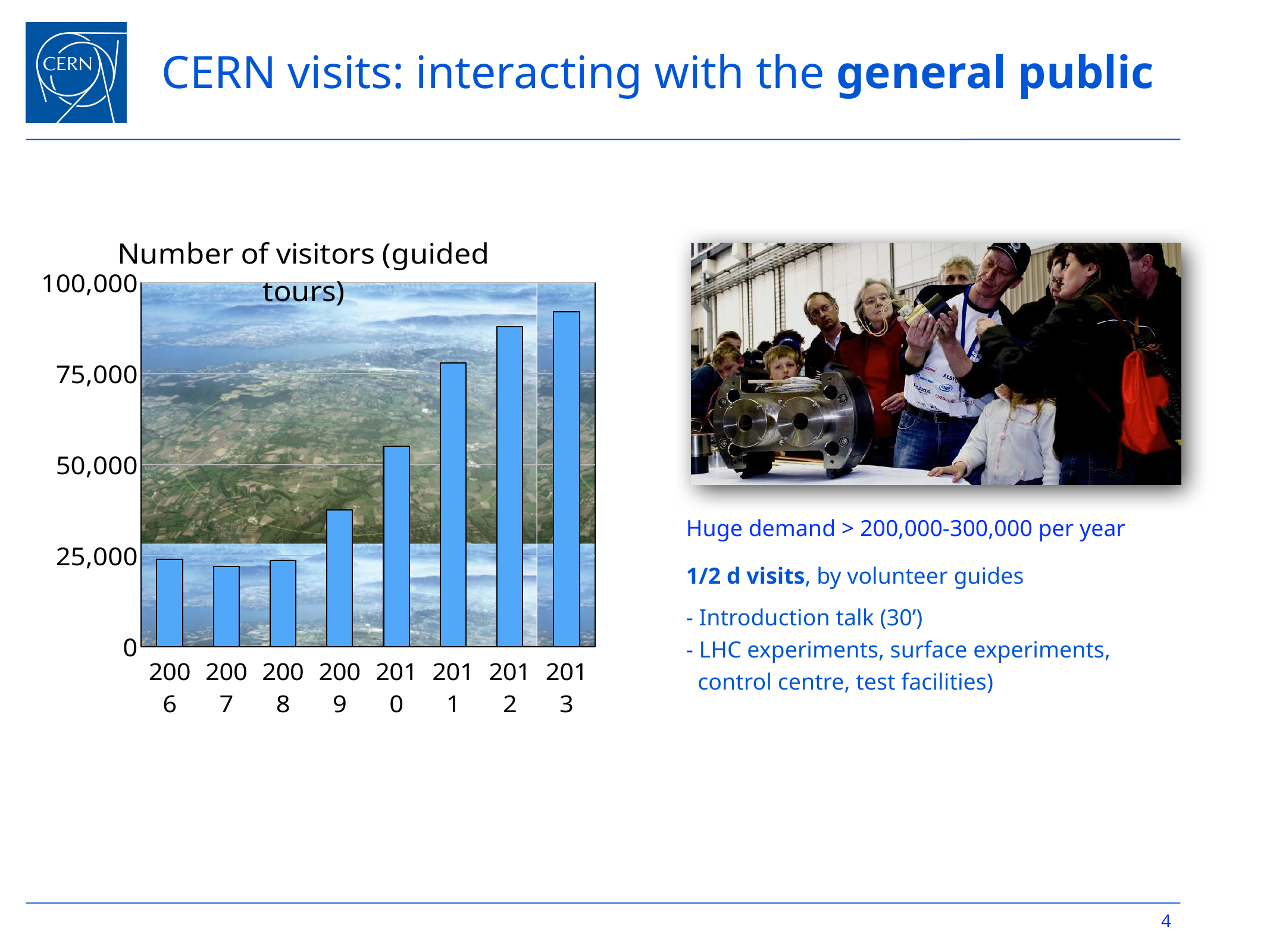
How many years are shown on the x axis of the chart? 8 Is the value for 2012 greater or less than 100,000? less Which year has the highest number of visitors? 2013 Is the value for 2013 greater or less than 75,000? greater What is the title of the chart? Number of visitors (guided tours) Which year has more visitors, 2010 or 2012? 2012 Is the value for 2010 greater or less than 75,000? less Do the number of visitors generally rise or fall from 2008 to 2013? rise What kind of chart is shown on the slide? bar chart Which year has the lowest number of visitors? 2007